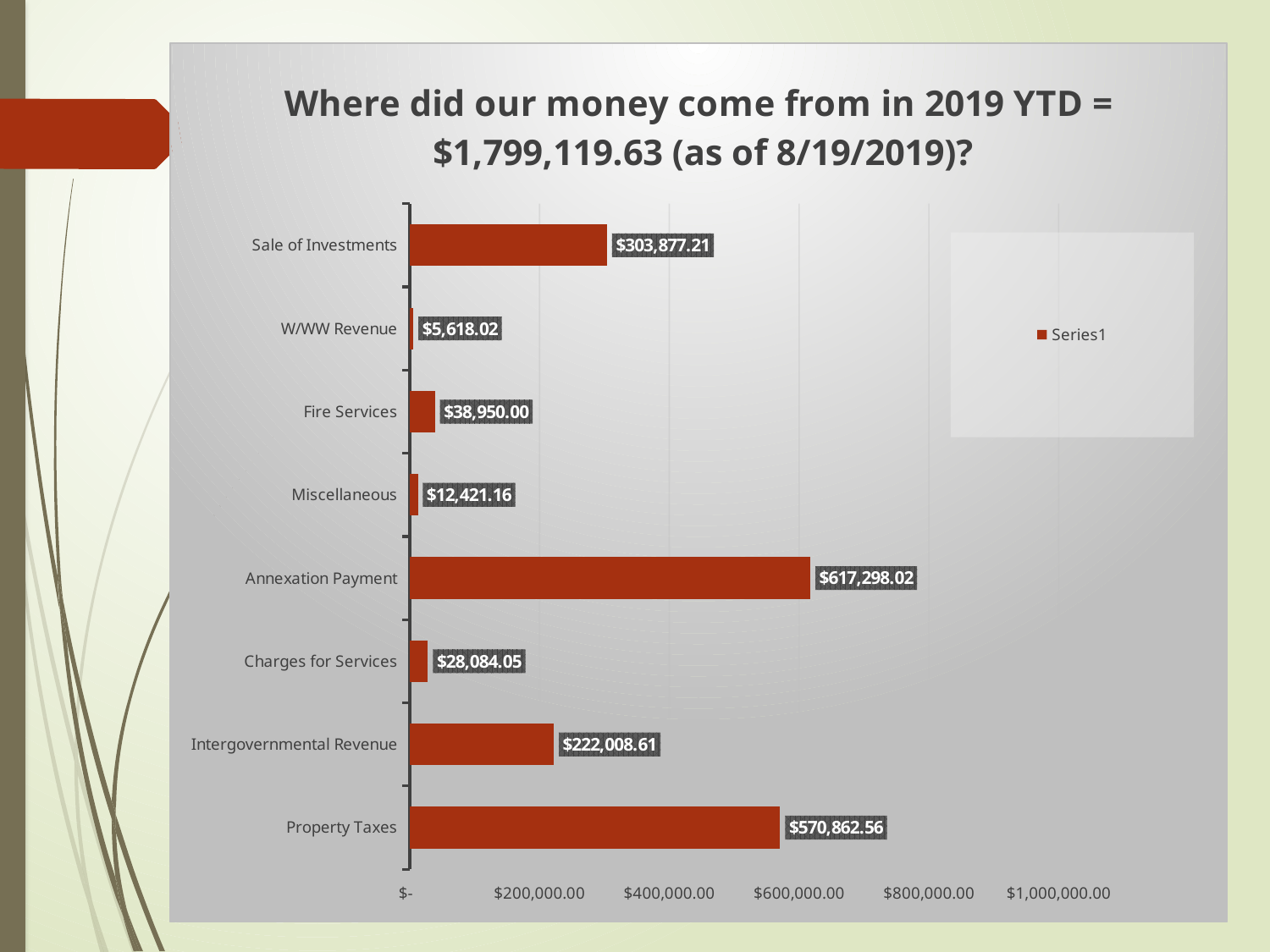
What is the value for W/WW Revenue? $5,618.02 What kind of chart is shown on the slide? Bar chart What is the difference between Sale of Investments and Intergovernmental Revenue? $81,868.60 What is the value for Annexation Payment? $617,298.02 What is the difference between Annexation Payment and Property Taxes? $46,435.46 Which is larger, Fire Services or Charges for Services? Fire Services Which category has the lowest value? W/WW Revenue What is the value for Intergovernmental Revenue? $222,008.61 Which category has the highest value? Annexation Payment How many categories are shown in the chart? 8 What is the value for Property Taxes? $570,862.56 What is the name of the series listed in the legend? Series1